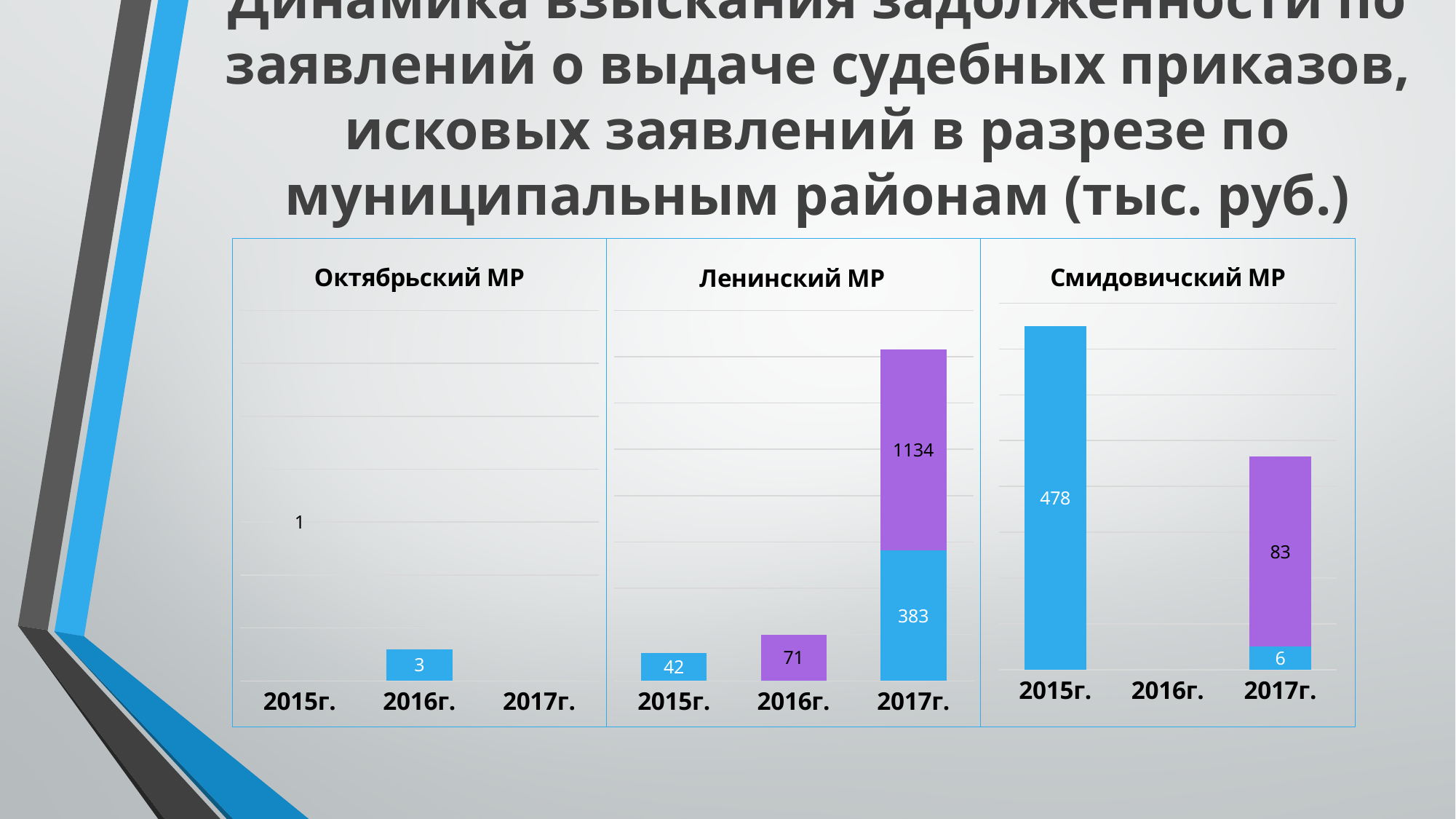
In the Ленинский МР panel, which year has the highest bar? 2017г. In the Ленинский МР panel, what is the total of the stacked 2017г. bar? 1517 How many municipal district panels does the chart show? 3 In the Ленинский МР panel, what is the difference between the 2016г. and 2015г. values? 29 Which is larger: the total 2017г. bar in Ленинский МР or the 2015г. bar in Смидовичский МР? 2017г. bar in Ленинский МР In the Ленинский МР panel, what is the value for 2016г.? 71 In the Смидовичский МР panel, what is the total of the stacked 2017г. bar? 89 In the Ленинский МР panel, what is the value for 2015г.? 42 In the Октябрьский МР panel, what is the value labelled on the 2016г. bar? 3 In the Ленинский МР panel, what is the value of the purple segment of the 2017г. bar? 1134 What kind of chart is shown on the slide? Bar chart In the Смидовичский МР panel, what is the value for 2015г.? 478